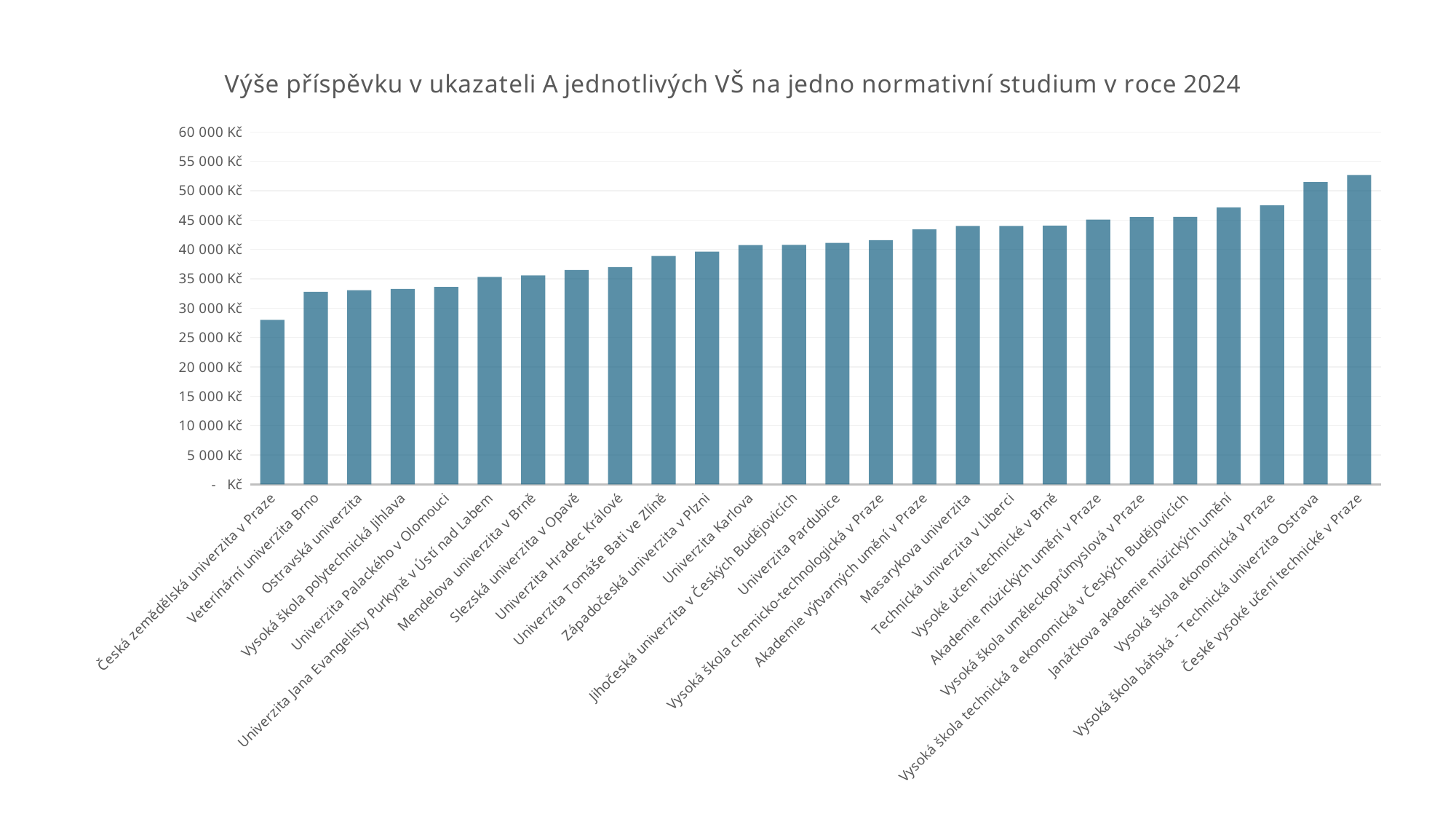
Is the value for Česká zemědělská univerzita v Praze greater or less than 30 000 Kč? less Is the value for Masarykova univerzita greater or less than 45 000 Kč? less Is the value for Univerzita Hradec Králové greater or less than 35 000 Kč? greater Do the values generally rise or fall from left to right along the x axis? rise What kind of chart is shown on the slide? bar chart How many universities (bars) are shown in the chart? 26 Which has a larger value, Univerzita Karlova or Veterinární univerzita Brno? Univerzita Karlova Which university has the highest value in the chart? České vysoké učení technické v Praze What is the title of the chart? Výše příspěvku v ukazateli A jednotlivých VŠ na jedno normativní studium v roce 2024 Which university has the lowest value in the chart? Česká zemědělská univerzita v Praze